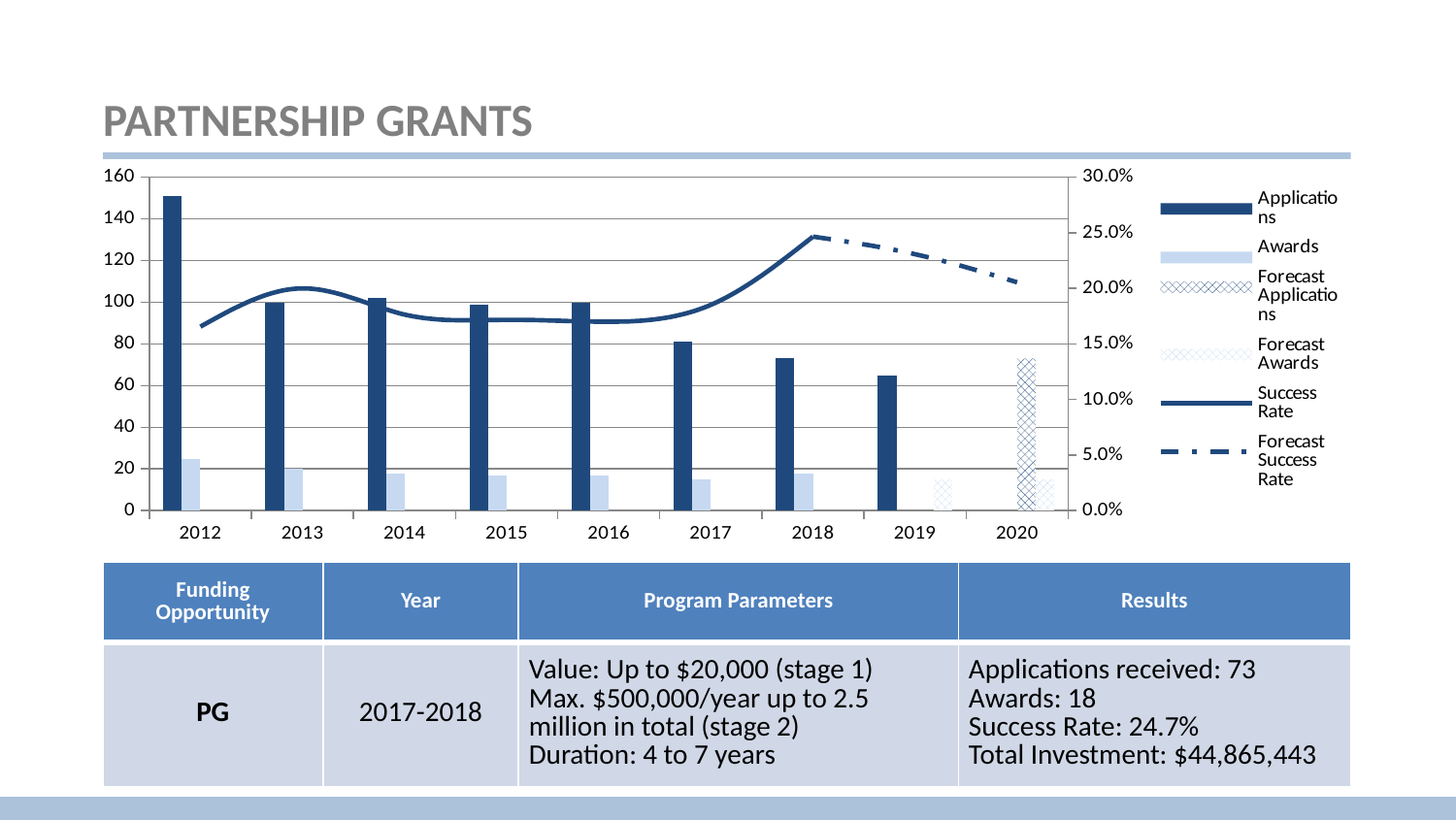
How many series does the chart legend list? 6 Which year has a higher Applications bar, 2012 or 2013? 2012 Is the Applications value for 2019 greater or less than 80? less Do the Applications bars generally rise or fall from 2012 to 2019? fall Which year has the lowest Applications bar? 2019 How many years are shown on the x axis of the chart? 9 Is the Success Rate for 2018 greater or less than 20.0%? greater In which year does the Success Rate line reach its peak? 2018 Is the Applications value for 2012 greater or less than 140? greater Which year has the highest Applications bar? 2012 What kind of chart is shown on the slide? bar and line chart Which year has a higher Applications bar, 2017 or 2018? 2017